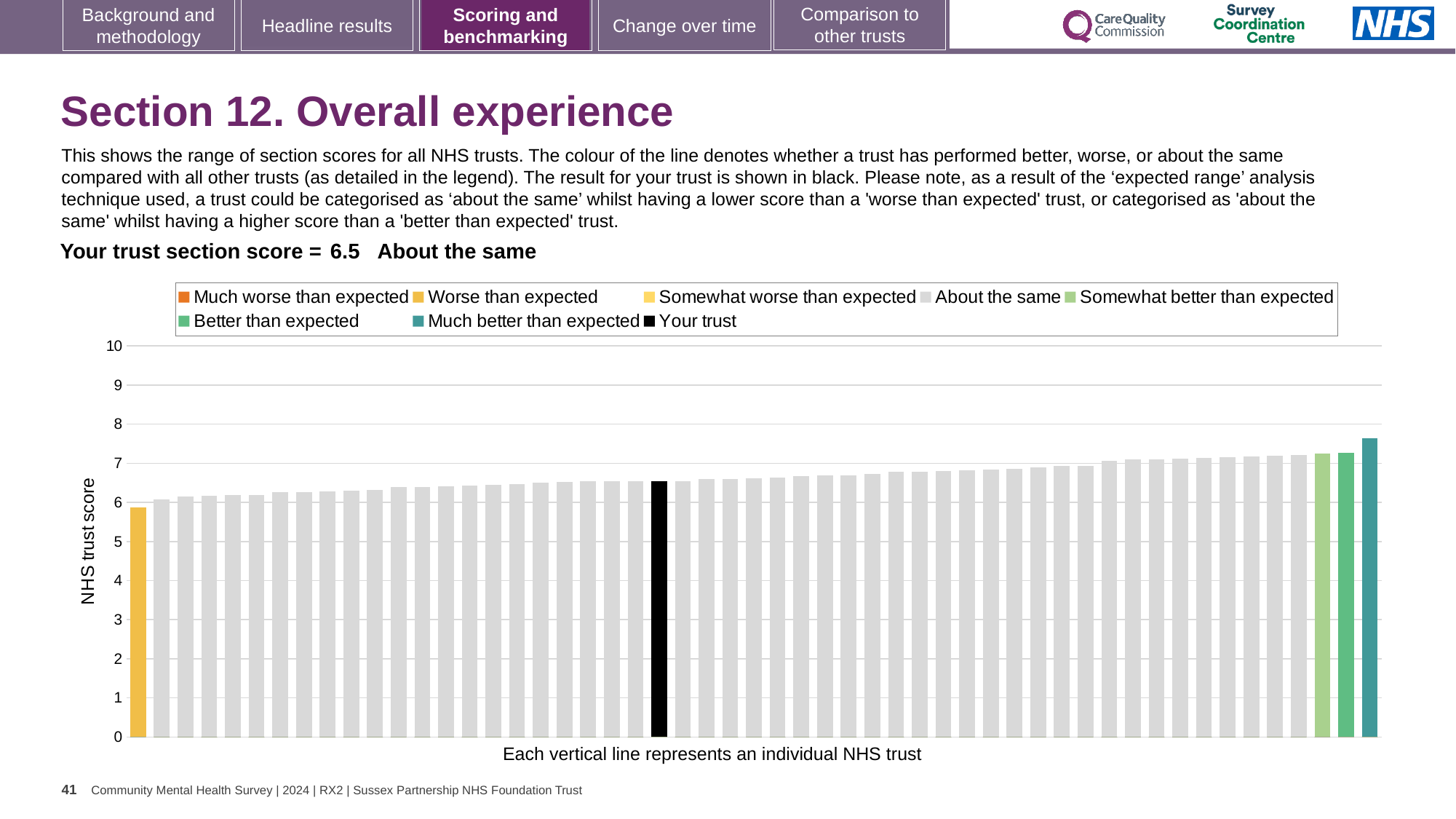
How many entries does the chart legend list? 8 What colour is the bar representing your trust? black What is the label on the vertical axis of the chart? NHS trust score Is the value for your trust (the black bar) greater or less than 6? greater What is your trust's section score for Section 12, Overall experience? 6.5 Which legend category does the tallest bar belong to? Much better than expected How many bars on the chart are not coloured grey? 5 Is the value of the tallest bar greater or less than 8? less Is the value of the tallest bar (the teal bar on the far right) greater or less than 7? greater Do the bar values rise or fall from left to right along the x axis? rise Which legend category does the shortest bar (the first bar on the left) belong to? Worse than expected What kind of chart is shown on the slide? bar chart